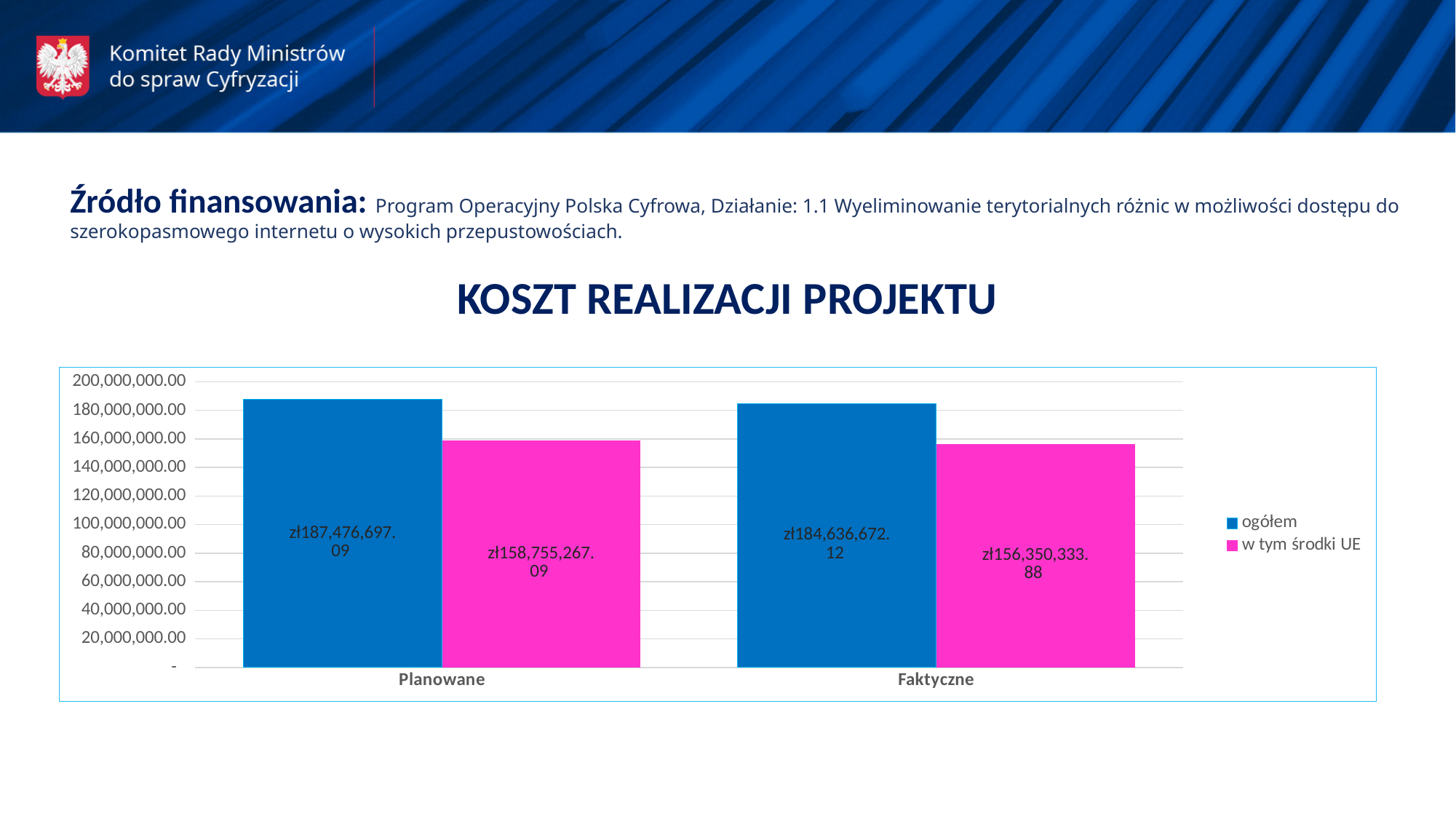
What is the difference between ogółem and w tym środki UE for Planowane? zł28,721,430.00 Which is larger: ogółem for Planowane or ogółem for Faktyczne? ogółem for Planowane What is the value of w tym środki UE for Faktyczne? zł156,350,333.88 Which bar in the chart has the lowest value? w tym środki UE for Faktyczne How many series does the chart legend list? 2 What is the value of ogółem for Faktyczne? zł184,636,672.12 What is the value of ogółem for Planowane? zł187,476,697.09 What is the value of w tym środki UE for Planowane? zł158,755,267.09 What is the difference between the ogółem values for Planowane and Faktyczne? zł2,840,024.97 How many categories are shown on the x axis of the chart? 2 What type of chart is shown on the slide? bar chart Which bar in the chart has the highest value? ogółem for Planowane